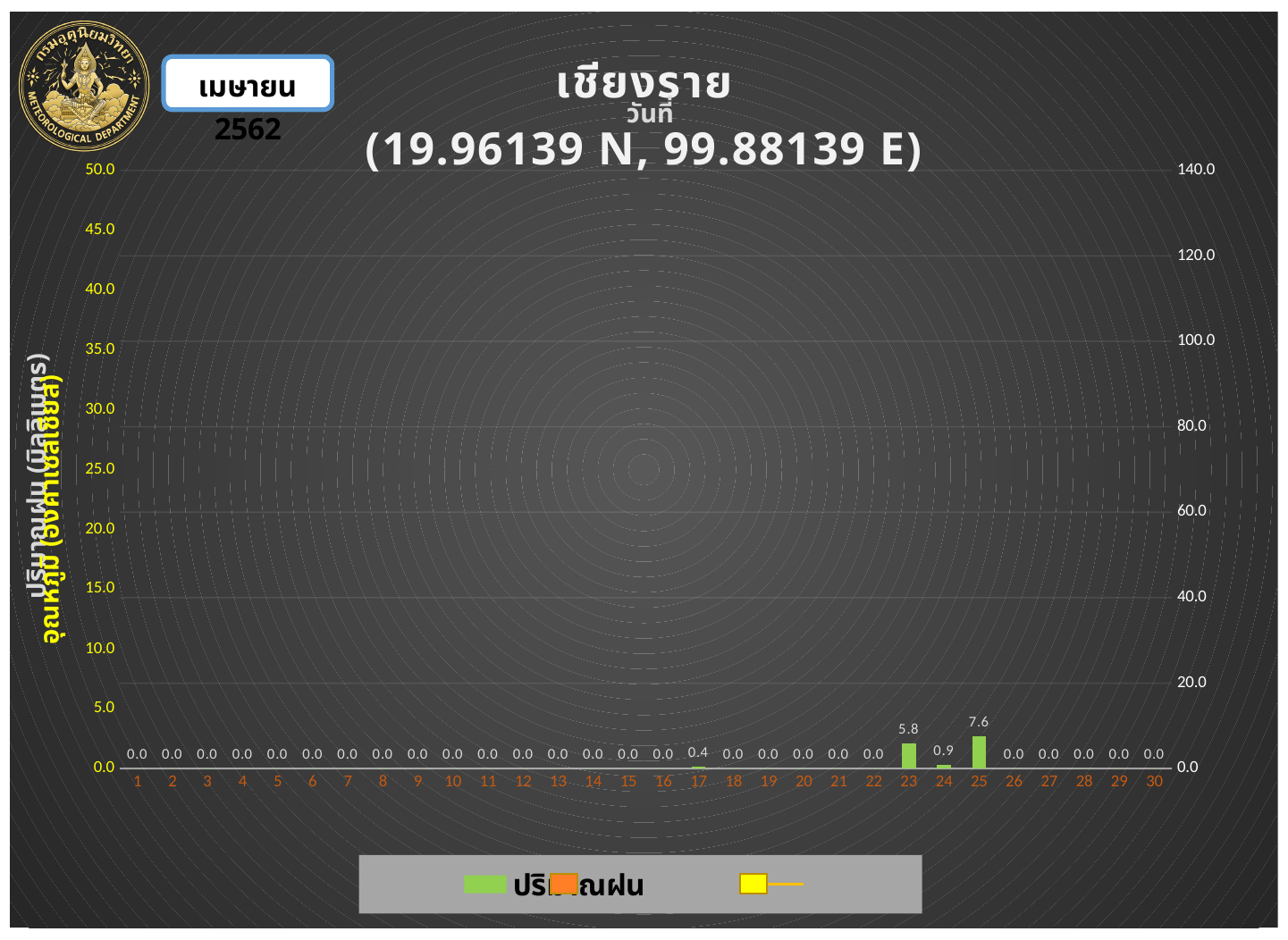
What is the rainfall value shown for day 17? 0.4 Which day has the highest rainfall value? 25 What is the rainfall value shown for day 23? 5.8 Which is larger, the rainfall value for day 23 or for day 24? day 23 Is the rainfall value for day 25 greater or less than 10.0 on the left axis? less What is the rainfall value shown for day 10? 0.0 What is the rainfall value shown for day 24? 0.9 What location name is given in the chart title? เชียงราย What kind of chart is shown on the slide? bar chart How many days are shown on the x axis? 30 What is the difference between the rainfall values for day 25 and day 23? 1.8 What is the rainfall value shown for day 25? 7.6